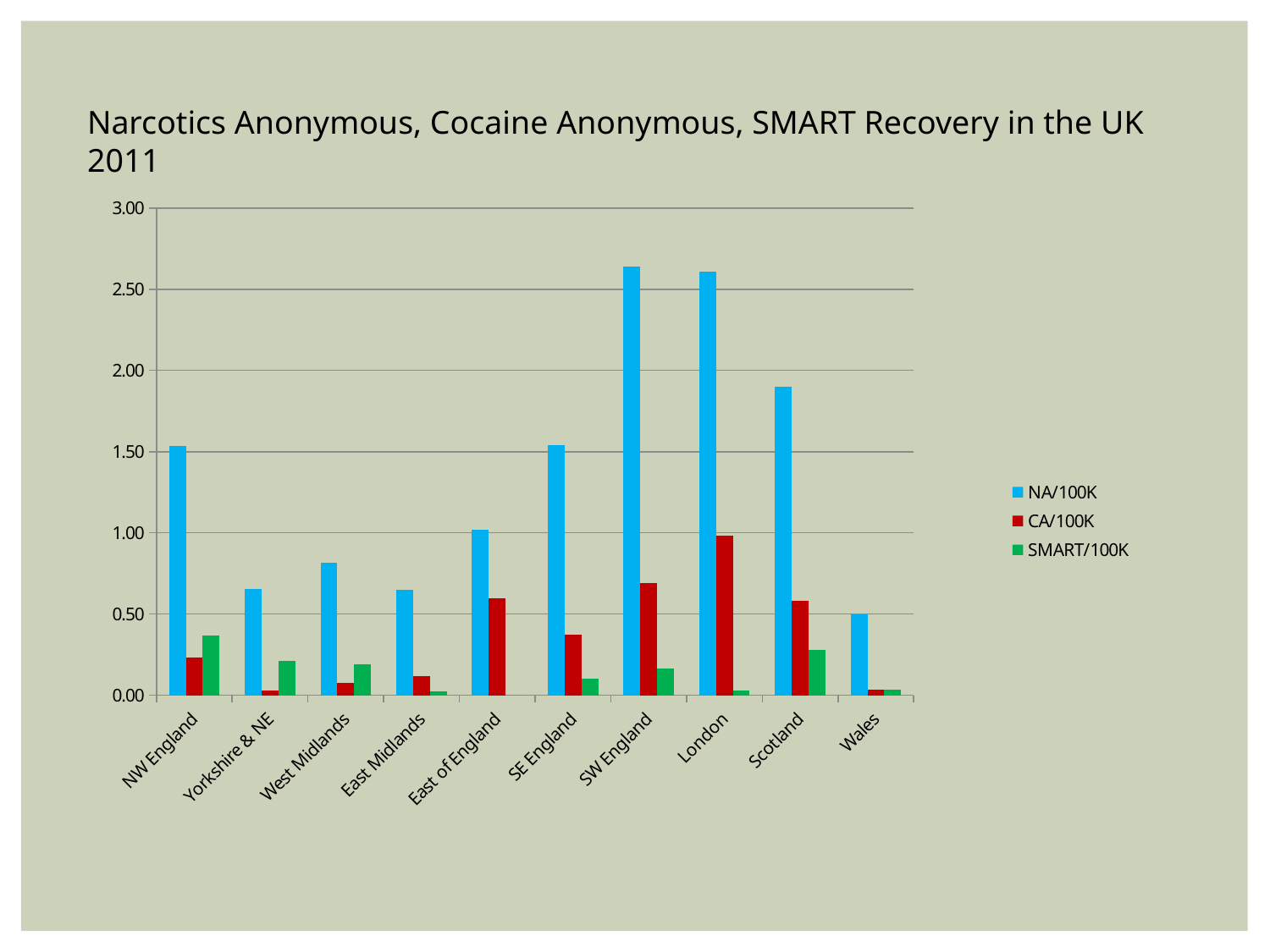
How many series does the legend list? 3 Which region has the highest CA/100K value? London How many regions are shown along the x axis? 10 Is the NA/100K value for SW England greater or less than 2.50? greater Is the NA/100K value for Scotland greater or less than 1.50? greater Which colour represents the SMART/100K series in the legend? green Which is larger, the NA/100K value for Scotland or for East of England? Scotland What kind of chart is shown on the slide? bar chart Which region has the lowest NA/100K value? Wales Is the CA/100K value for SE England greater or less than 0.50? less Which is larger, the CA/100K value for East of England or for SE England? East of England Which region has the highest SMART/100K value? NW England